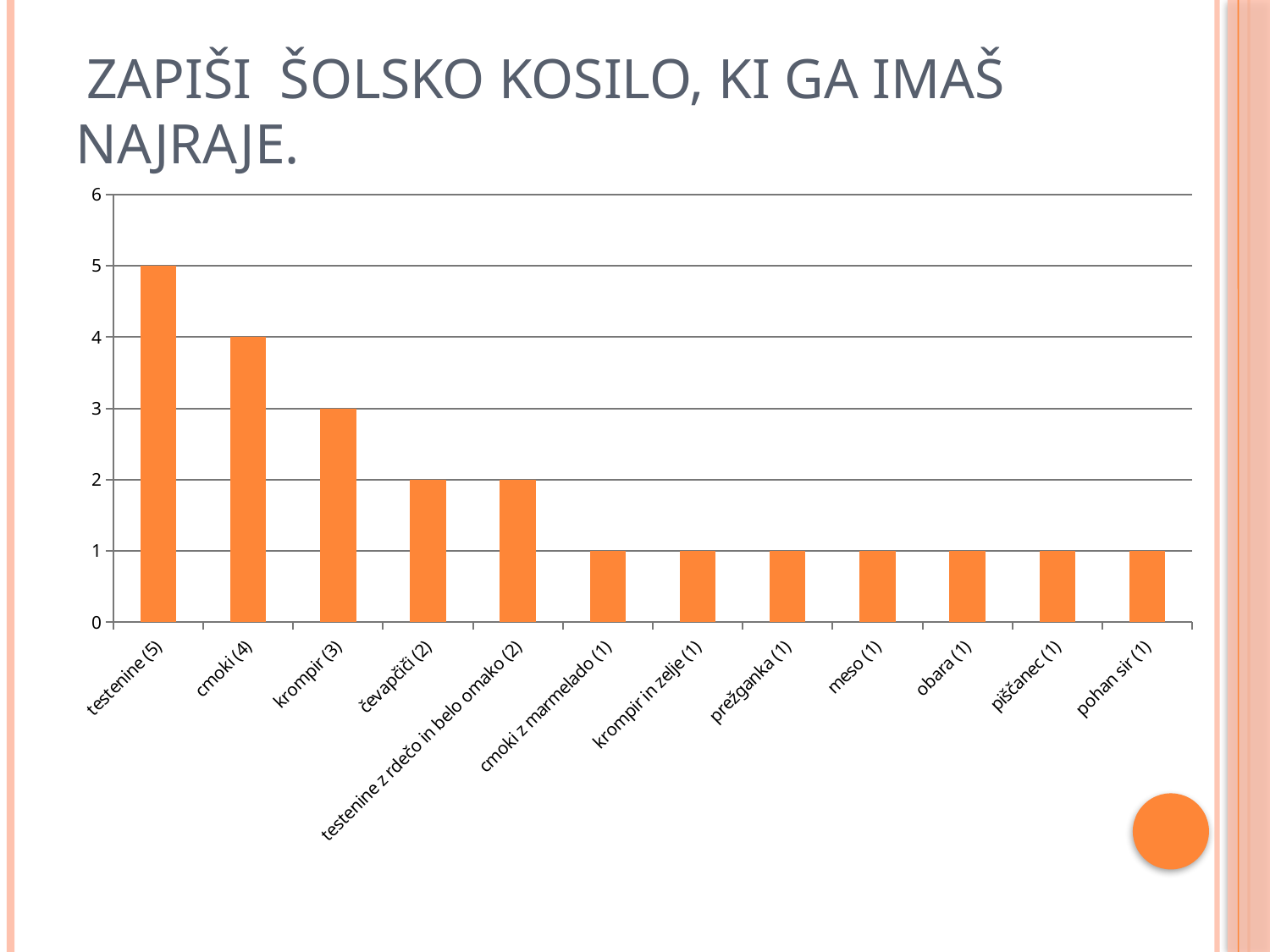
What is the title of the slide above the chart? ZAPIŠI ŠOLSKO KOSILO, KI GA IMAŠ NAJRAJE. How many categories are plotted in the chart? 12 What is the value for čevapčiči? 2 What is the value for krompir? 3 What kind of chart is shown on the slide? bar chart Do the values rise or fall moving from left to right along the x axis? fall Which category has the highest value in the chart? testenine (5) What is the difference between the values for testenine and cmoki? 1 Which is larger, the value for krompir or the value for čevapčiči? krompir What is the difference between the values for testenine and pohan sir? 4 What is the value for cmoki? 4 What is the value for prežganka? 1